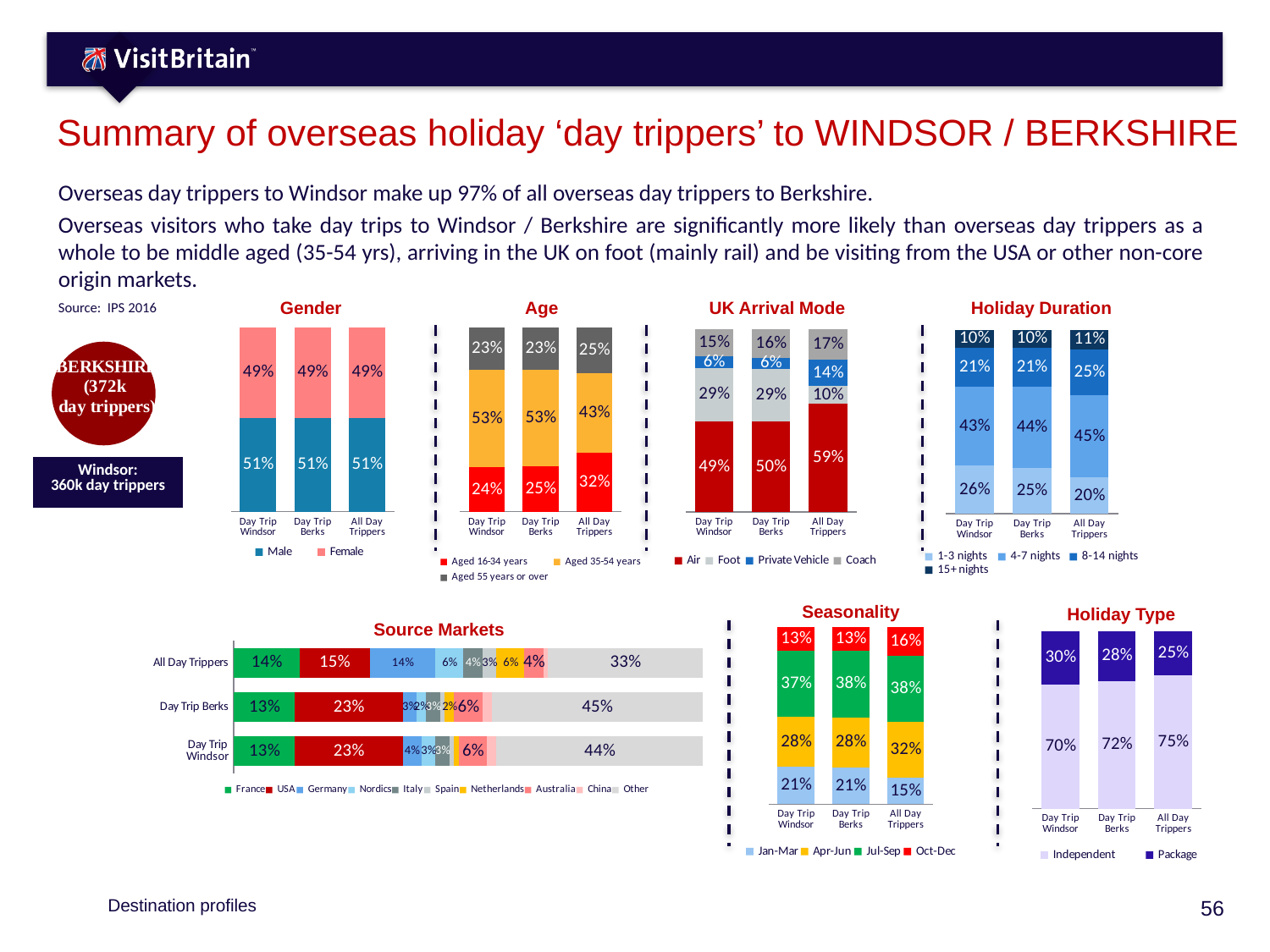
In the Holiday Duration chart, what share of Day Trip Berks visitors stay 4-7 nights? 44% In the Holiday Duration chart, how many series does the legend list? 4 In the Age chart, what is the difference between the Aged 16-34 years share for All Day Trippers and for Day Trip Windsor? 8% In the Gender chart, what percentage of Day Trip Windsor visitors are Male? 51% In the UK Arrival Mode chart, which category has the highest Air share? All Day Trippers In the UK Arrival Mode chart, what percentage of Day Trip Windsor visitors arrive by Foot? 29% In the Seasonality chart, what is the Jul-Sep share for Day Trip Windsor? 37% In the Holiday Type chart, is the Independent share larger for Day Trip Windsor or All Day Trippers? All Day Trippers In the Age chart, what share of All Day Trippers are Aged 35-54 years? 43% What kind of chart is the Holiday Type chart? Stacked bar chart In the Source Markets chart, which category has the largest Other share? Day Trip Berks In the Source Markets chart, what is the USA share for Day Trip Windsor? 23%